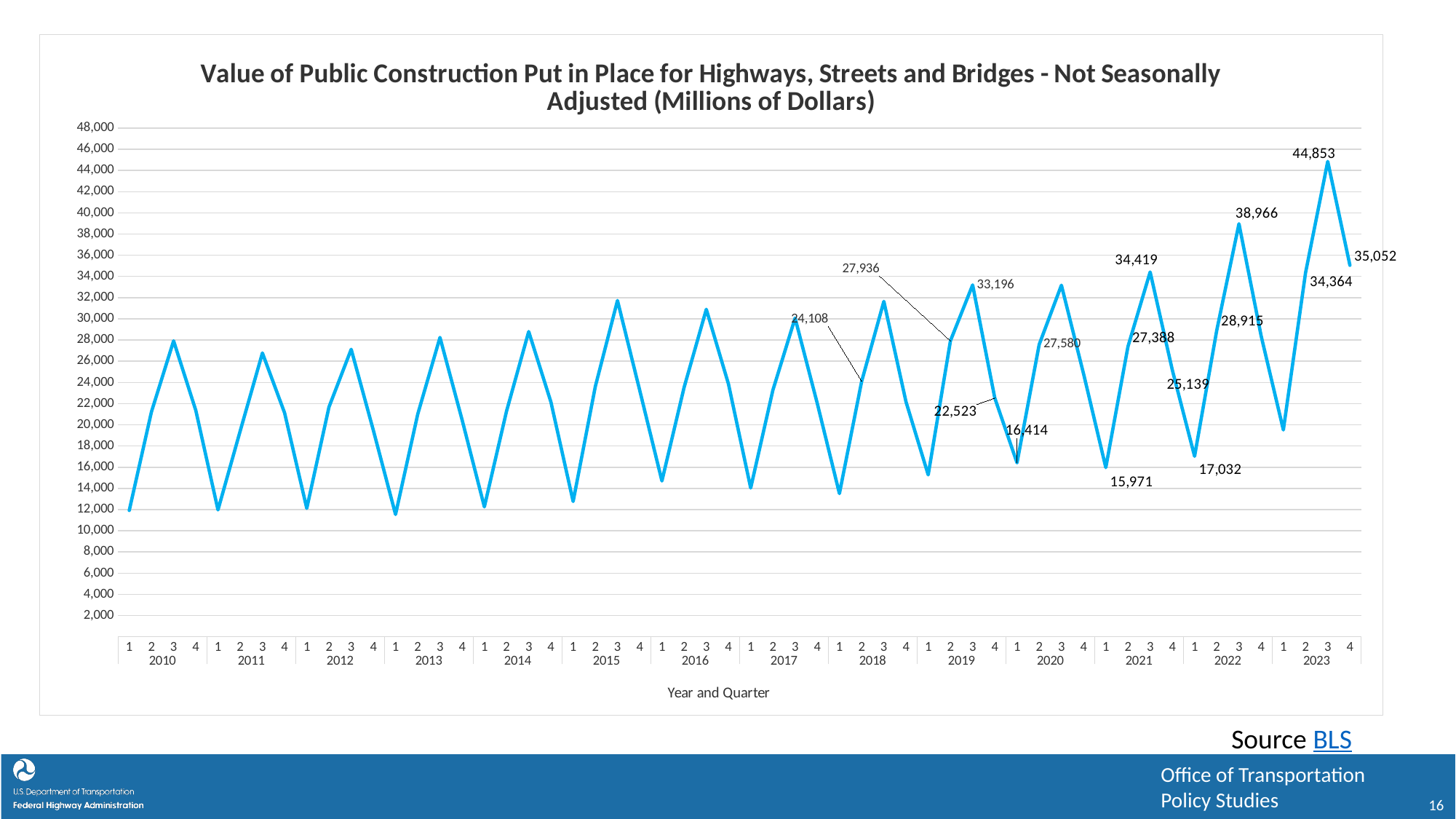
How many years are shown on the x axis? 14 What is the value for quarter 3 of 2022? 38,966 What is the value for quarter 3 of 2023? 44,853 Which quarter has the highest value on the chart? Quarter 3 of 2023 (44,853) What is the value for quarter 3 of 2019? 33,196 Is the value for quarter 3 of 2010 greater or less than 30,000? less What kind of chart is shown on the slide? Line chart What is the difference between the values for quarter 3 of 2023 and quarter 4 of 2023? 9,801 What is the difference between the values for quarter 3 of 2023 and quarter 3 of 2022? 5,887 Which is larger, the value for quarter 3 of 2019 or quarter 3 of 2021? Quarter 3 of 2021 What is the value for quarter 1 of 2021? 15,971 What is the value for quarter 4 of 2023? 35,052